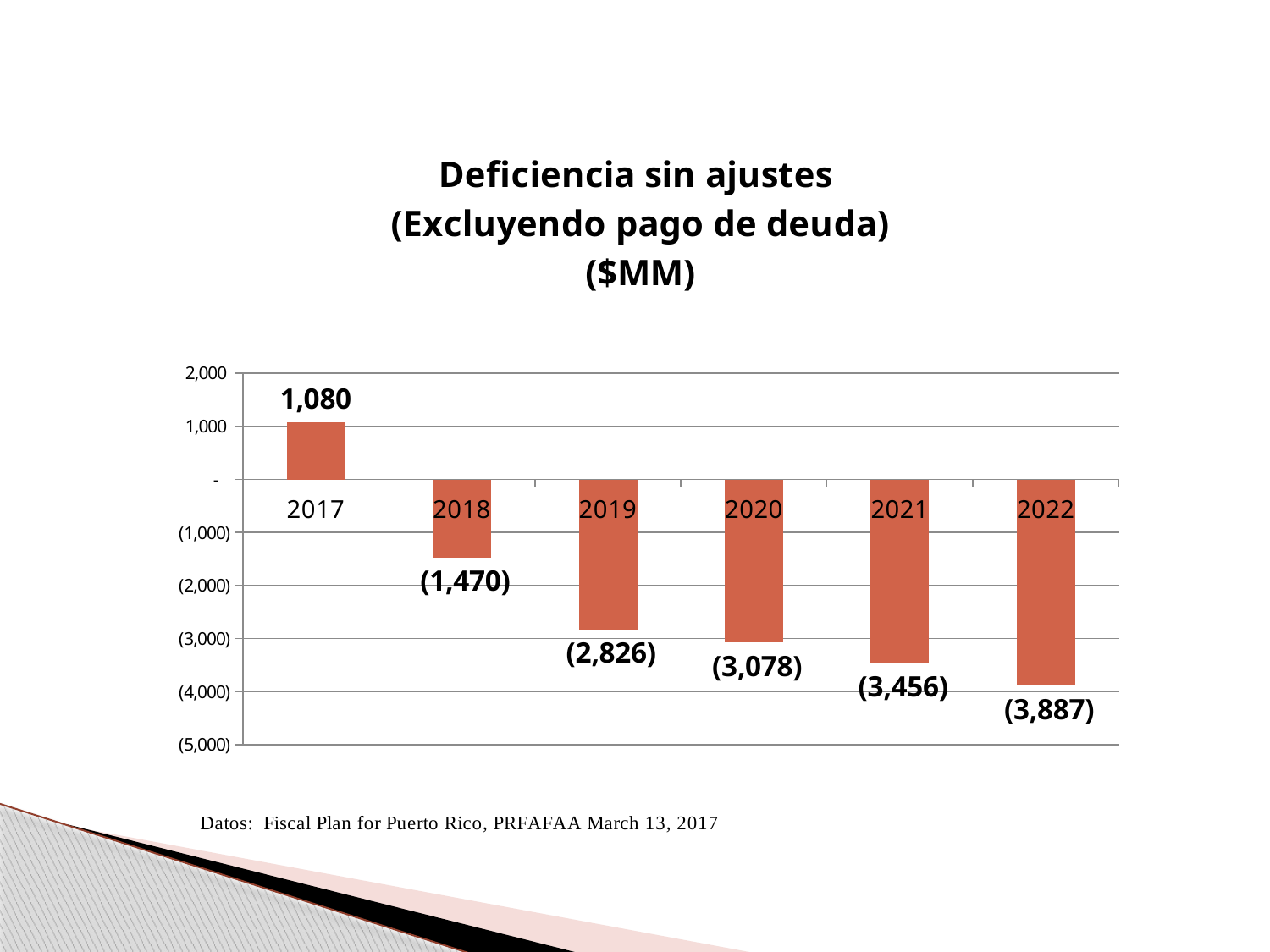
What kind of chart is shown on the slide? Bar chart What is the value for 2020? (3,078) Do the values rise or fall from 2017 to 2022? Fall By how much does the deficit in 2022 exceed the deficit in 2021, in absolute terms? 431 How many years are shown on the x axis? 6 What is the value for 2017? 1,080 Which year has the highest value? 2017 What is the value for 2022? (3,887) Which year has the larger value, 2018 or 2021? 2018 By how much does the deficit in 2019 exceed the deficit in 2018, in absolute terms? 1,356 What is the value for 2019? (2,826) Which year has the lowest value? 2022